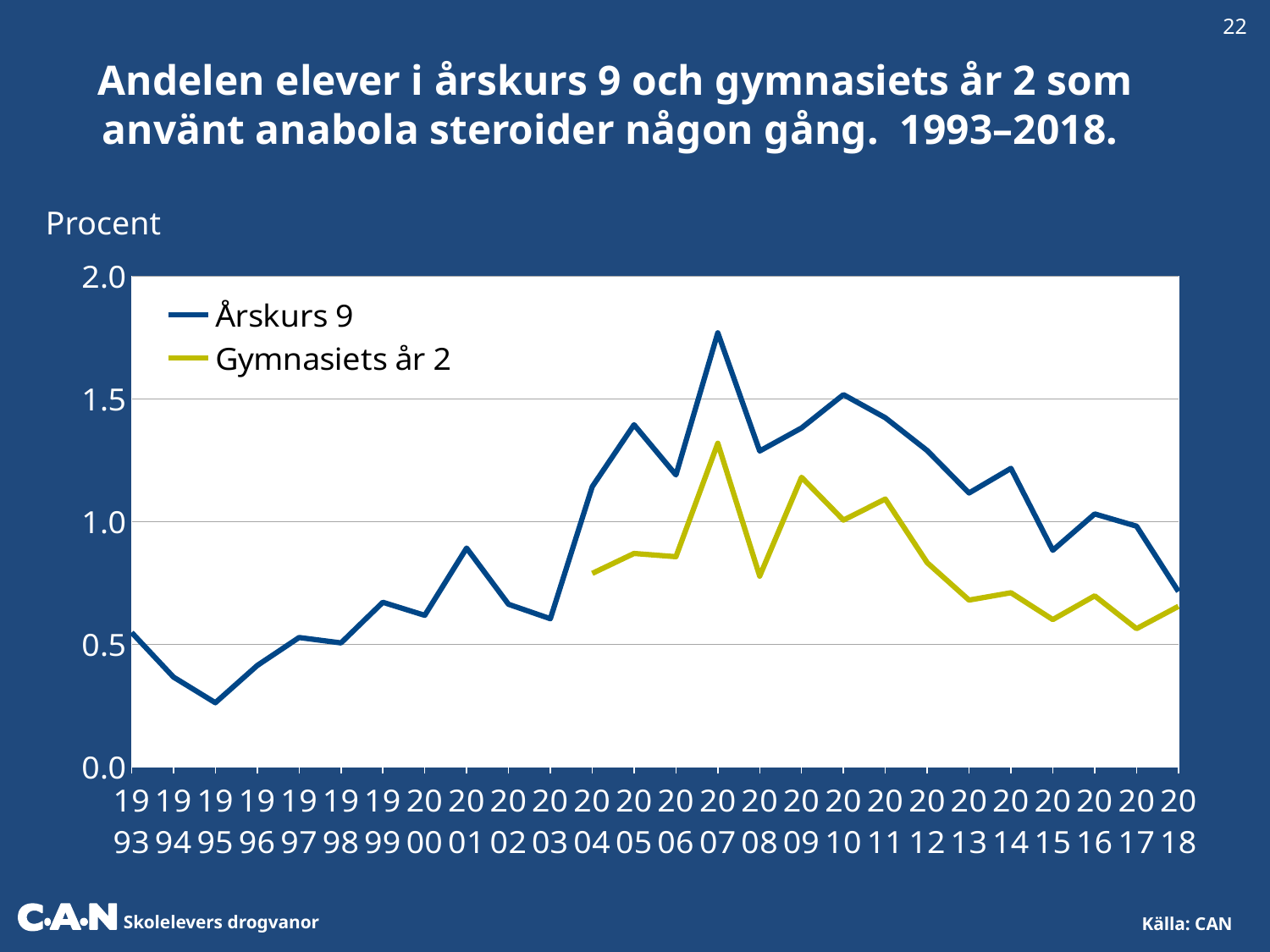
In which year does the Gymnasiets år 2 series reach its highest value? 2007 How many series does the legend list? 2 In which year does the Årskurs 9 series reach its lowest value? 1995 In which year does the Årskurs 9 series reach its highest value? 2007 How many years are shown along the x axis? 26 Which series has the higher value in 2010, Årskurs 9 or Gymnasiets år 2? Årskurs 9 Is the value for Årskurs 9 in 1995 greater or less than 0.5? less What kind of chart is shown on the slide? Line chart Is the value for Årskurs 9 in 2007 greater or less than 1.5? greater What unit label is shown above the y axis? Procent Is the value for Gymnasiets år 2 in 2017 greater or less than 1.0? less Does the Årskurs 9 series generally rise or fall between 2007 and 2018? Fall